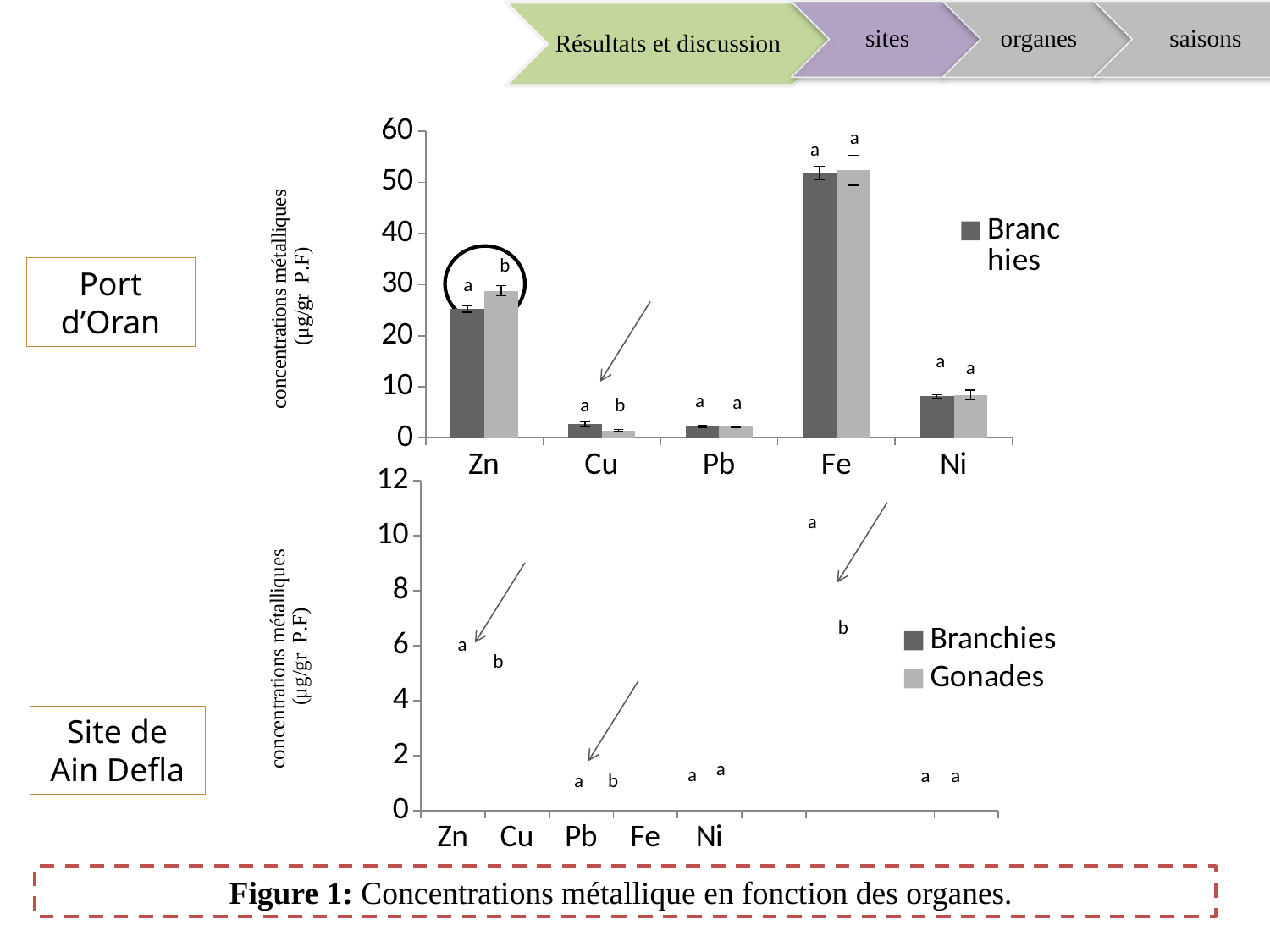
In the Port d'Oran chart, which is larger for Branchies: Fe or Ni? Fe In the Port d'Oran chart, which metal has the highest concentration for Gonades? Fe What is the y-axis label of the Site de Ain Defla chart? concentrations métalliques (µg/gr P.F) In the Port d'Oran chart, which metal has the highest concentration for Branchies? Fe In the Port d'Oran chart, is the Branchies value for Fe greater or less than 40? greater In the Port d'Oran chart, is the Branchies value for Zn greater or less than 20? greater How many metals are shown on the x axis of the Port d'Oran chart? 5 How many series does the legend of the Site de Ain Defla chart list? 2 What kind of chart is the Port d'Oran chart at the top of the slide? bar chart In the Port d'Oran chart, is the Gonades value for Ni greater or less than 10? less In the Port d'Oran chart, which is larger for Zn: the Branchies value or the Gonades value? Gonades